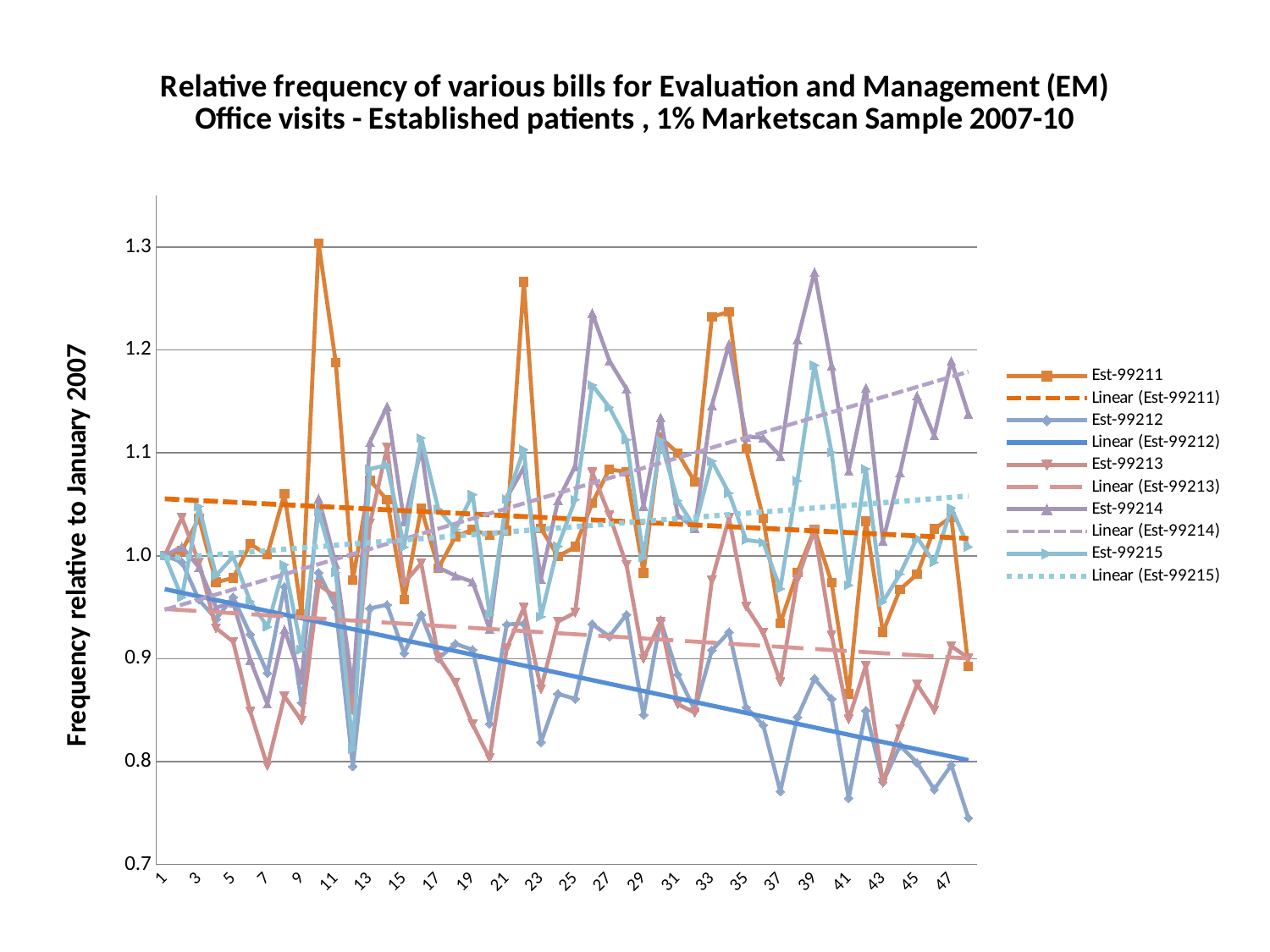
Which series reaches the lowest point on the chart? Est-99212 Is the value for Est-99212 at point 37 greater or less than 0.8? less Does the Linear (Est-99214) trendline rise or fall from left to right? rise How many entries does the legend list? 10 Is the value for Est-99212 at point 48 greater or less than 0.8? less Is the value for Est-99211 at point 10 greater or less than 1.2? greater What is the label of the vertical axis? Frequency relative to January 2007 Does the Linear (Est-99212) trendline rise or fall from left to right? fall What kind of chart is shown on the slide? line chart Which series reaches the highest point on the chart? Est-99211 What is the highest value shown on the vertical axis? 1.3